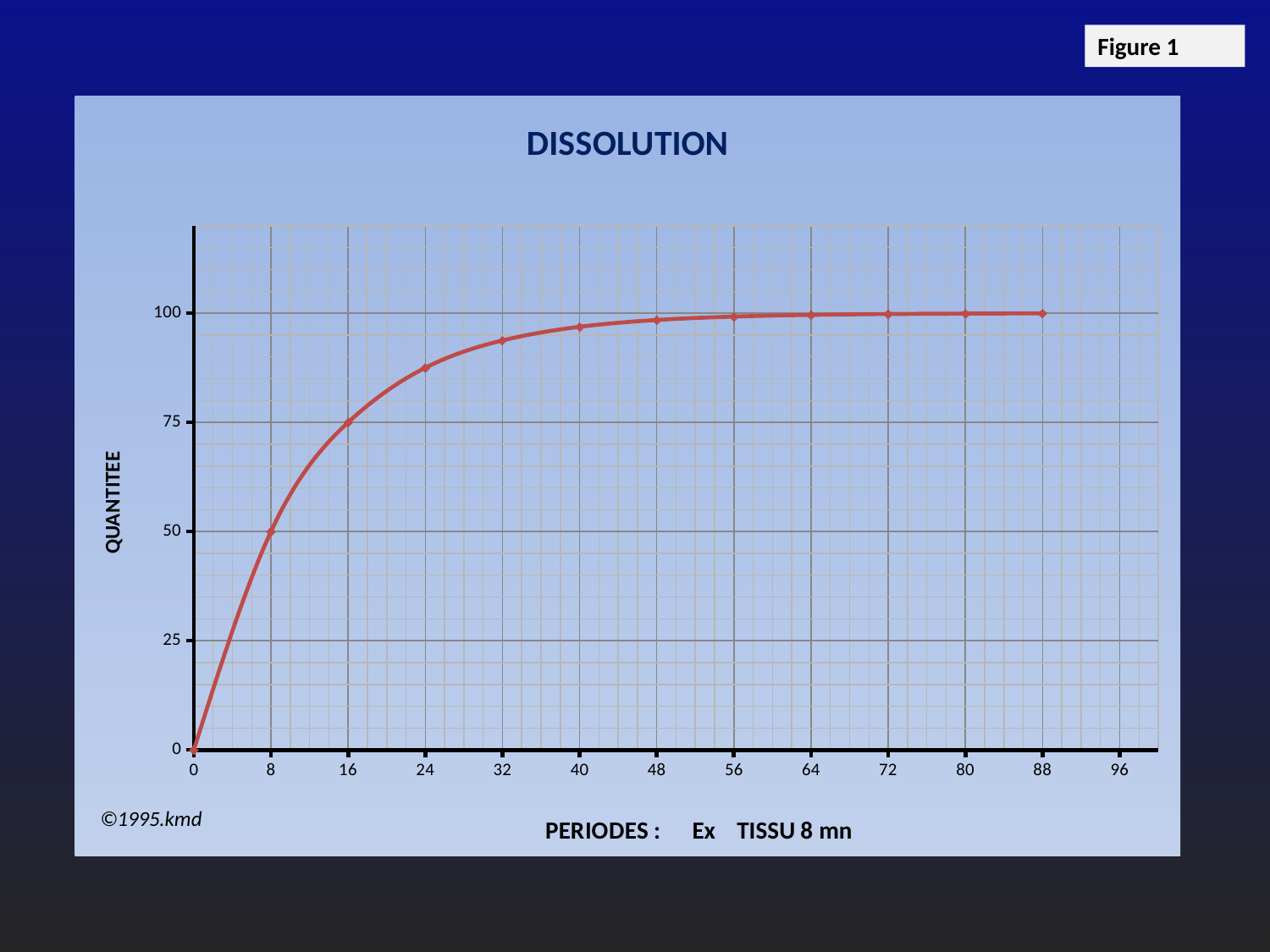
At which period is the value lowest? 0 Is the value at period 24 greater or less than 75? greater What is the QUANTITEE value at period 0? 0 What is the QUANTITEE value at period 16? 75 Is the value at period 32 greater or less than 100? less What is the QUANTITEE value at period 8? 50 What is the difference between the values at period 16 and period 8? 25 How many data points are plotted on the line? 12 Which has the larger value, period 8 or period 16? period 16 Do the values rise or fall as the periods increase along the x axis? rise What kind of chart is shown on the slide? line chart What is the title of the chart? DISSOLUTION